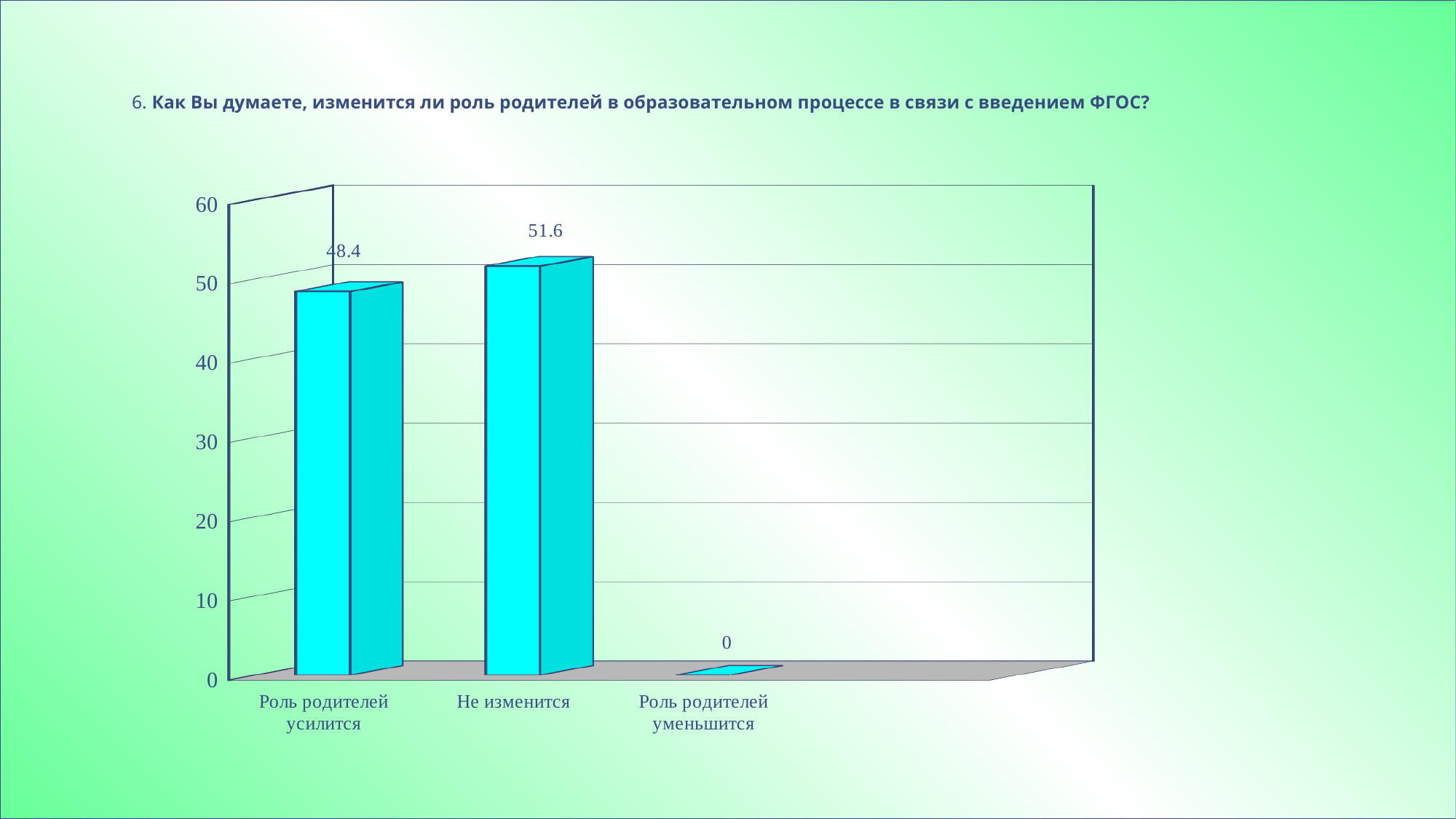
What kind of chart is shown on the slide? bar chart What is the value for "Не изменится"? 51.6 How many categories are shown on the chart? 3 Which category has the highest value? Не изменится Is the value for "Роль родителей усилится" greater or less than 50? less Which is larger: the value for "Не изменится" or the value for "Роль родителей усилится"? Не изменится What is the value for "Роль родителей усилится"? 48.4 Is the value for "Не изменится" greater or less than 50? greater What is the maximum value shown on the vertical axis? 60 Which category has the lowest value? Роль родителей уменьшится What is the value for "Роль родителей уменьшится"? 0 What is the difference between the values for "Не изменится" and "Роль родителей усилится"? 3.2